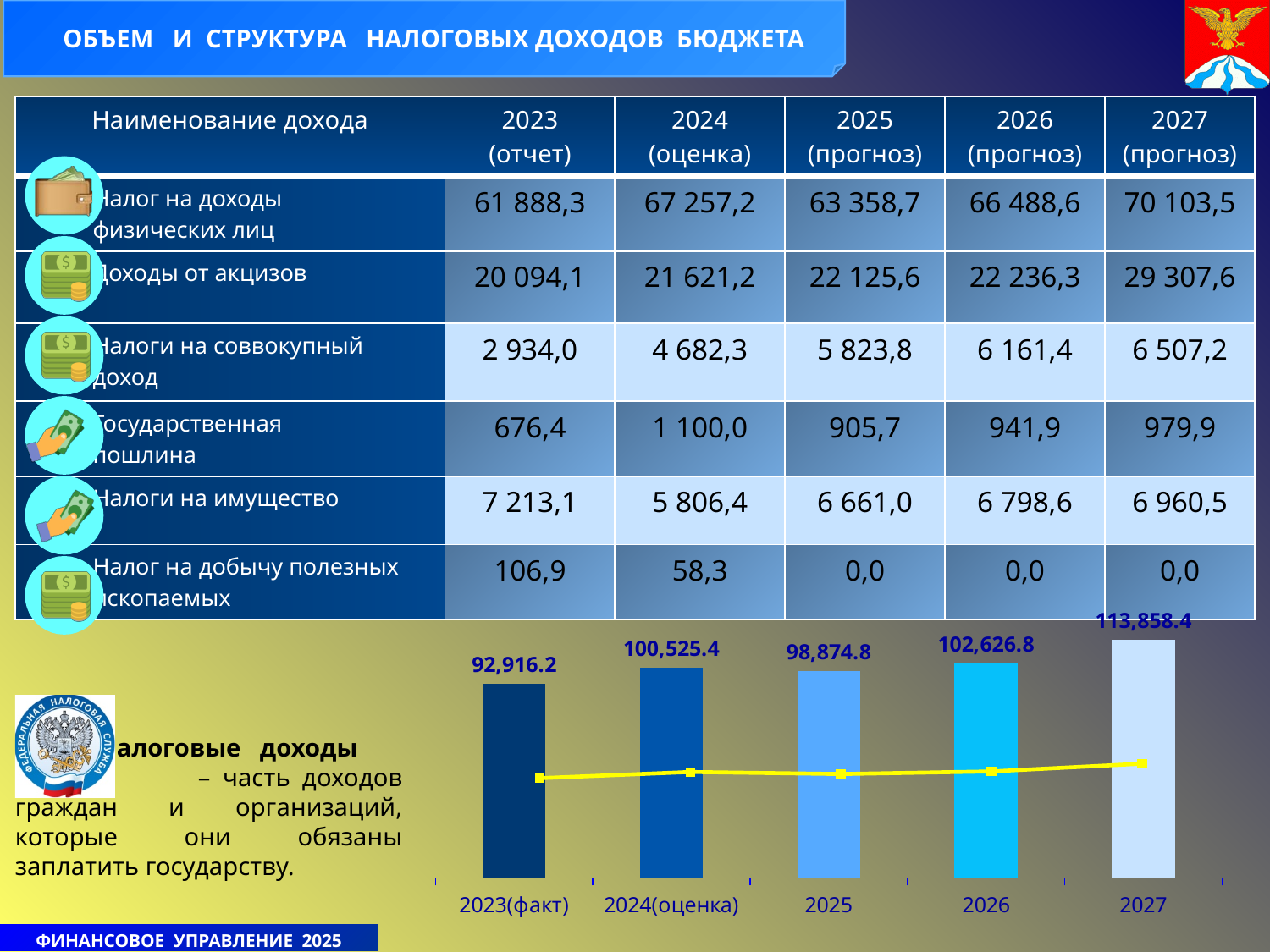
In the bar chart at the bottom of the slide, what is the value for 2023(факт)? 92,916.2 In the bar chart at the bottom of the slide, what is the difference between the values for 2024(оценка) and 2023(факт)? 7,609.2 In the bar chart at the bottom of the slide, which year has the lowest value? 2023(факт) What kind of chart is shown at the bottom of the slide? bar chart In the bar chart at the bottom of the slide, what is the value for 2027? 113,858.4 In the bar chart at the bottom of the slide, which is larger: the value for 2024(оценка) or the value for 2025? 2024(оценка) In the bar chart at the bottom of the slide, what is the value for 2025? 98,874.8 In the bar chart at the bottom of the slide, do the values rise or fall from 2025 to 2027? rise In the bar chart at the bottom of the slide, what colour is the line drawn across the bars? yellow In the bar chart at the bottom of the slide, which year has the highest value? 2027 How many bars are shown in the bar chart at the bottom of the slide? 5 In the bar chart at the bottom of the slide, what is the difference between the values for 2027 and 2026? 11,231.6